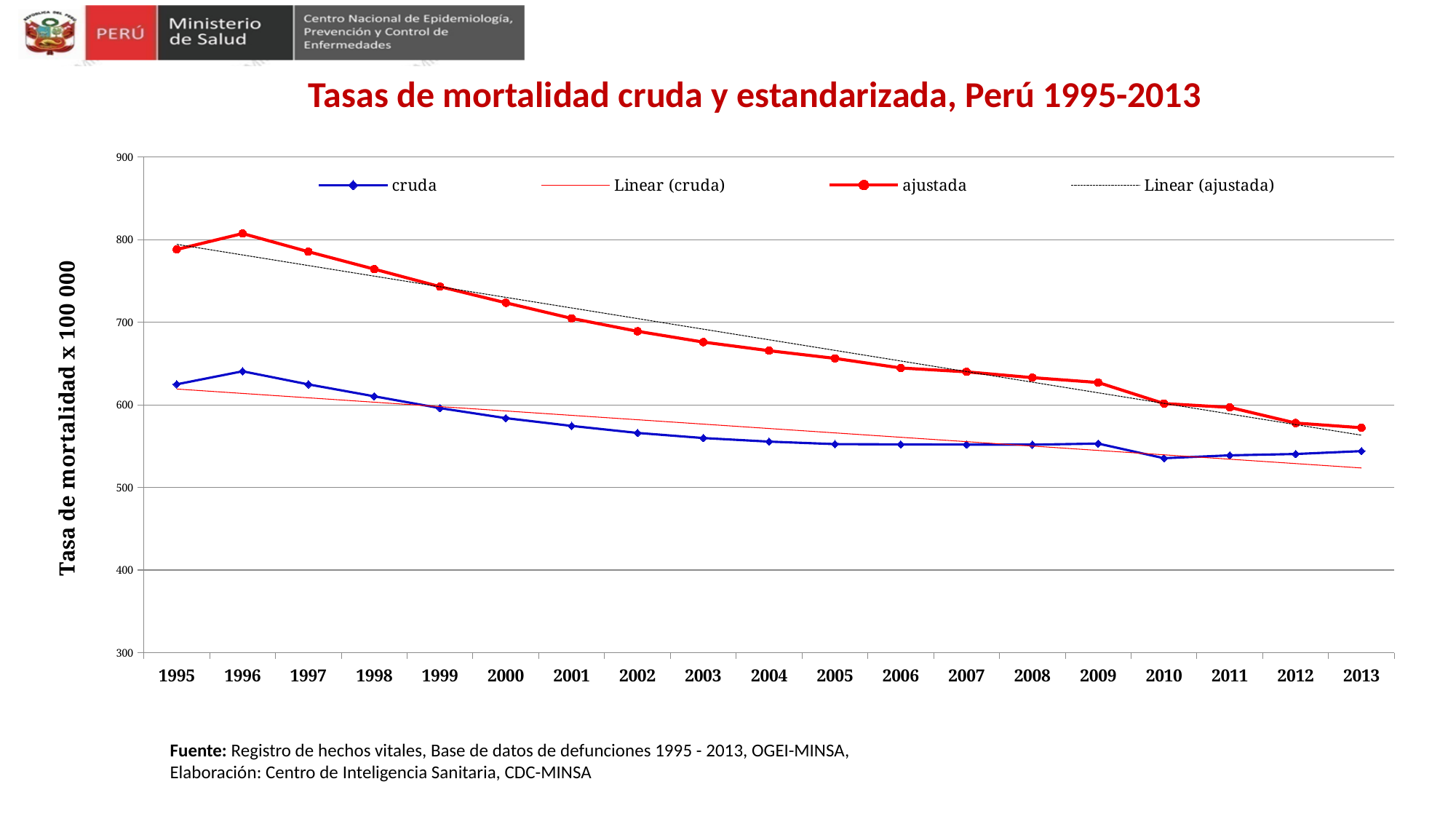
Is the 'cruda' value for 2010 greater or less than 550? less In 2005, which series has the higher value, 'cruda' or 'ajustada'? ajustada Is the 'cruda' value for 1995 greater or less than 600? greater In which year does the 'cruda' series reach its highest value? 1996 What kind of chart is shown on the slide? line chart Is the 'ajustada' value for 2013 greater or less than 600? less Overall, does the 'ajustada' series rise or fall from 1995 to 2013? fall How many entries does the chart legend list? 4 How many years are shown along the x axis? 19 In which year does the 'ajustada' series reach its highest value? 1996 In which year does the 'ajustada' series reach its lowest value? 2013